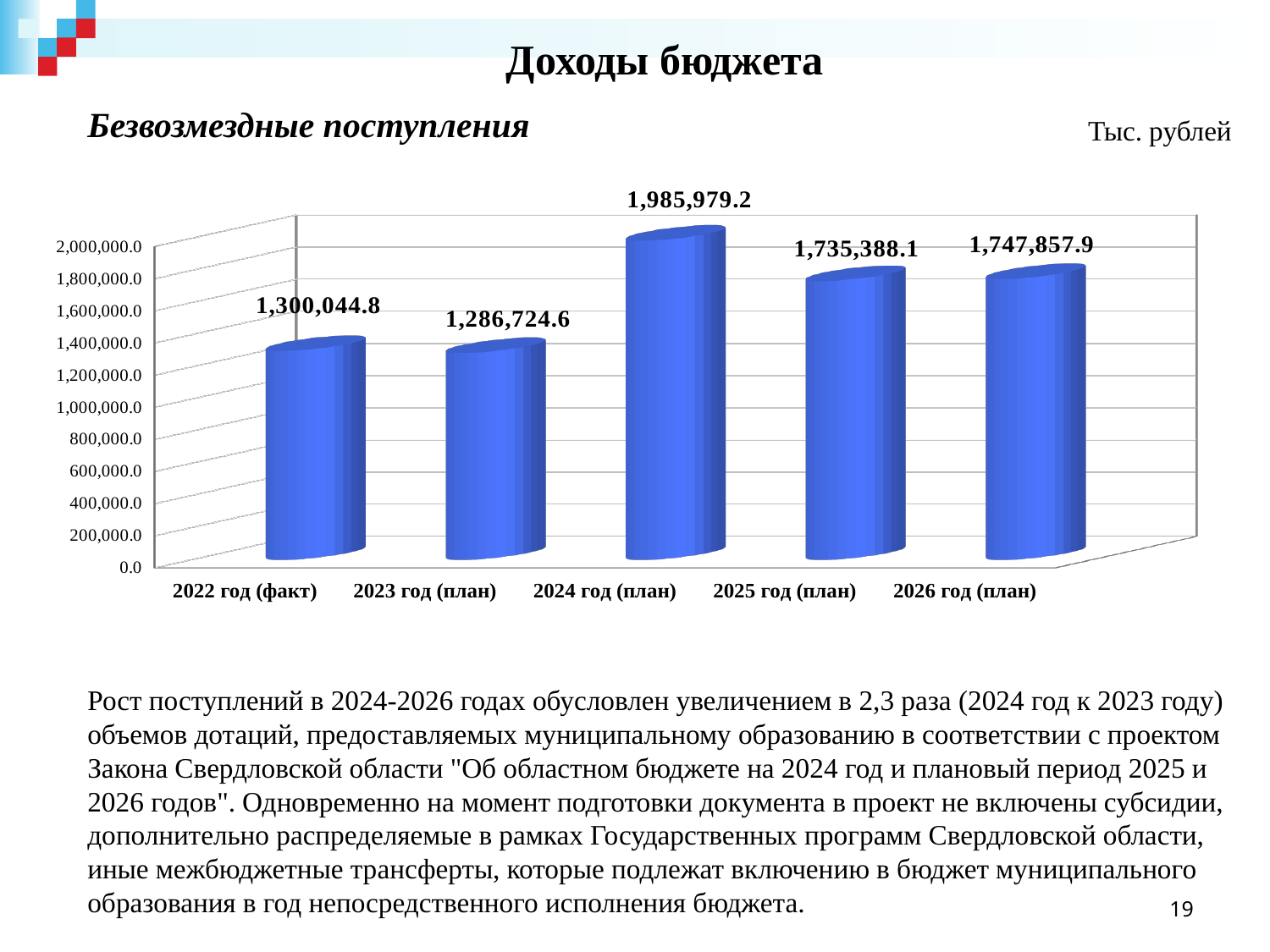
Which is larger, the value for 2024 год (план) or 2022 год (факт)? 2024 год (план) What is the difference between the values for 2024 год (план) and 2023 год (план)? 699,254.6 What is the value for 2024 год (план)? 1,985,979.2 What unit is stated for the chart values? Тыс. рублей How many categories are shown on the x axis? 5 What kind of chart is shown on the slide? bar chart Is the value for 2025 год (план) greater or less than 1,600,000.0? greater Which year has the highest value? 2024 год (план) Which year has the lowest value? 2023 год (план) What is the value for 2026 год (план)? 1,747,857.9 What is the value for 2022 год (факт)? 1,300,044.8 What is the difference between the values for 2026 год (план) and 2025 год (план)? 12,469.8